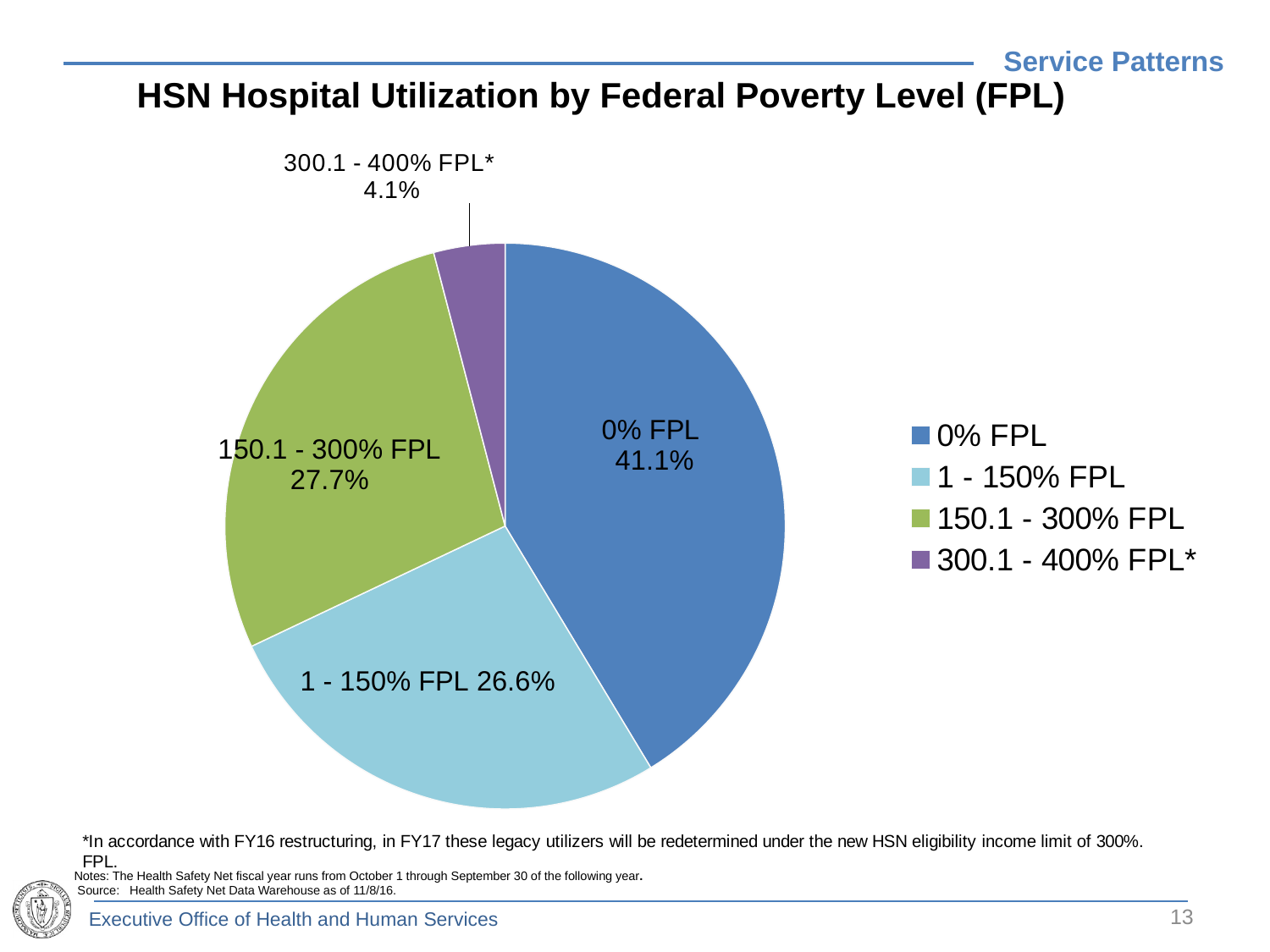
Which FPL group has the largest share of HSN hospital utilization? 0% FPL Which FPL group has the smallest share of HSN hospital utilization? 300.1 - 400% FPL* What type of chart is shown on the slide? Pie chart What share of HSN hospital utilization is for the 0% FPL group? 41.1% What is the difference in percentage points between the 150.1 - 300% FPL share and the 1 - 150% FPL share? 1.1 What share of HSN hospital utilization is for the 1 - 150% FPL group? 26.6% What share of HSN hospital utilization is for the 150.1 - 300% FPL group? 27.7% What share of HSN hospital utilization is for the 300.1 - 400% FPL* group? 4.1% What is the title of the chart? HSN Hospital Utilization by Federal Poverty Level (FPL) How many FPL groups are shown in the pie chart? 4 What is the difference in percentage points between the 0% FPL share and the 150.1 - 300% FPL share? 13.4 Which has a larger share: 1 - 150% FPL or 300.1 - 400% FPL*? 1 - 150% FPL